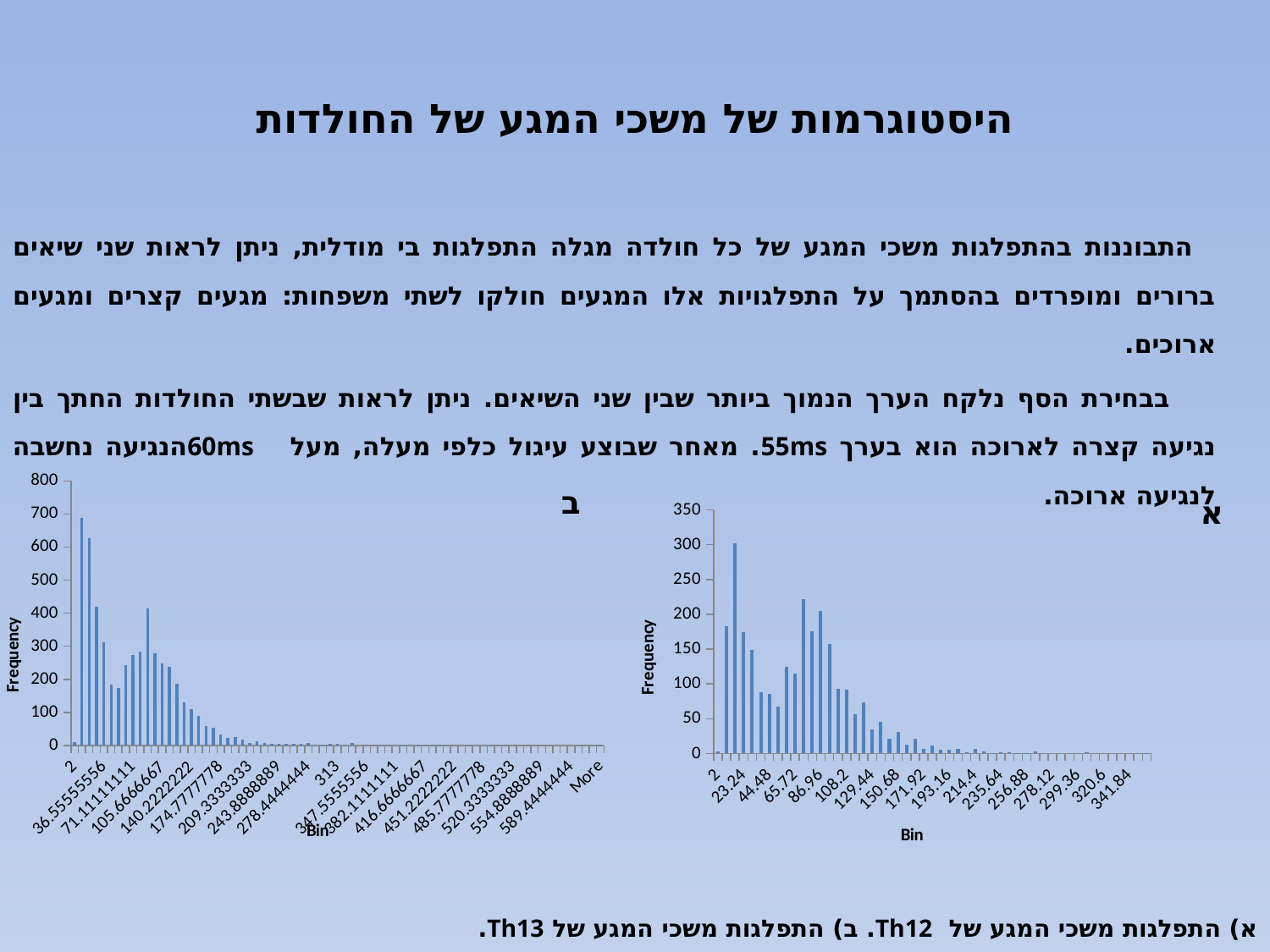
In the left chart (ב), do the bar heights generally rise or fall as the Bin values increase beyond 209.3333333? fall What is the highest tick value shown on the Frequency axis of the right chart (א)? 350 In the left chart (ב), is the tallest bar greater or less than 600 on the Frequency axis? greater How many charts are shown on the slide? 2 In the right chart (א), do the bar heights generally rise or fall as the Bin values increase beyond 150.68? fall What is the label of the vertical axis on the left chart (ב)? Frequency In the left chart (ב), is the tallest bar greater or less than 800 on the Frequency axis? less What kind of chart is the chart on the right of the slide (labelled א)? bar chart What is the label of the horizontal axis on the right chart (א)? Bin In the right chart (א), is the tallest bar greater or less than 250 on the Frequency axis? greater What kind of chart is the chart on the left of the slide (labelled ב)? bar chart